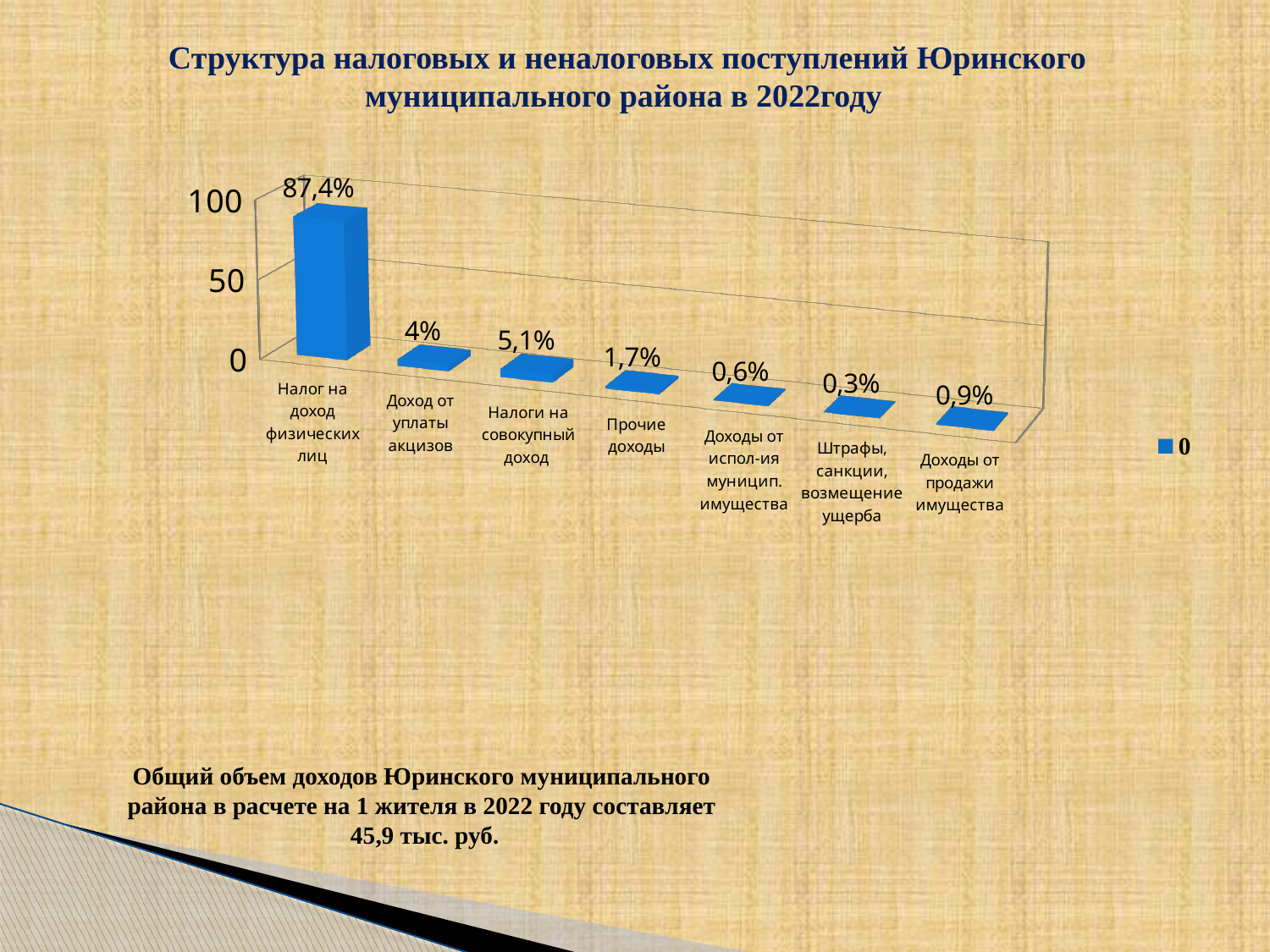
What is the difference between the values for Налог на доход физических лиц and Налоги на совокупный доход? 82,3% What kind of chart is shown on the slide? bar chart Which category has the lowest value? Штрафы, санкции, возмещение ущерба What is the value for Штрафы, санкции, возмещение ущерба? 0,3% What is the value for Налог на доход физических лиц? 87,4% Is the value for Налог на доход физических лиц greater or less than 50? greater How many categories are shown in the chart? 7 What is the value for Налоги на совокупный доход? 5,1% What is the difference between the values for Прочие доходы and Доходы от испол-ия муницип. имущества? 1,1% Which is larger: the value for Доход от уплаты акцизов or the value for Налоги на совокупный доход? Налоги на совокупный доход Which category has the highest value? Налог на доход физических лиц What is the value for Доходы от продажи имущества? 0,9%